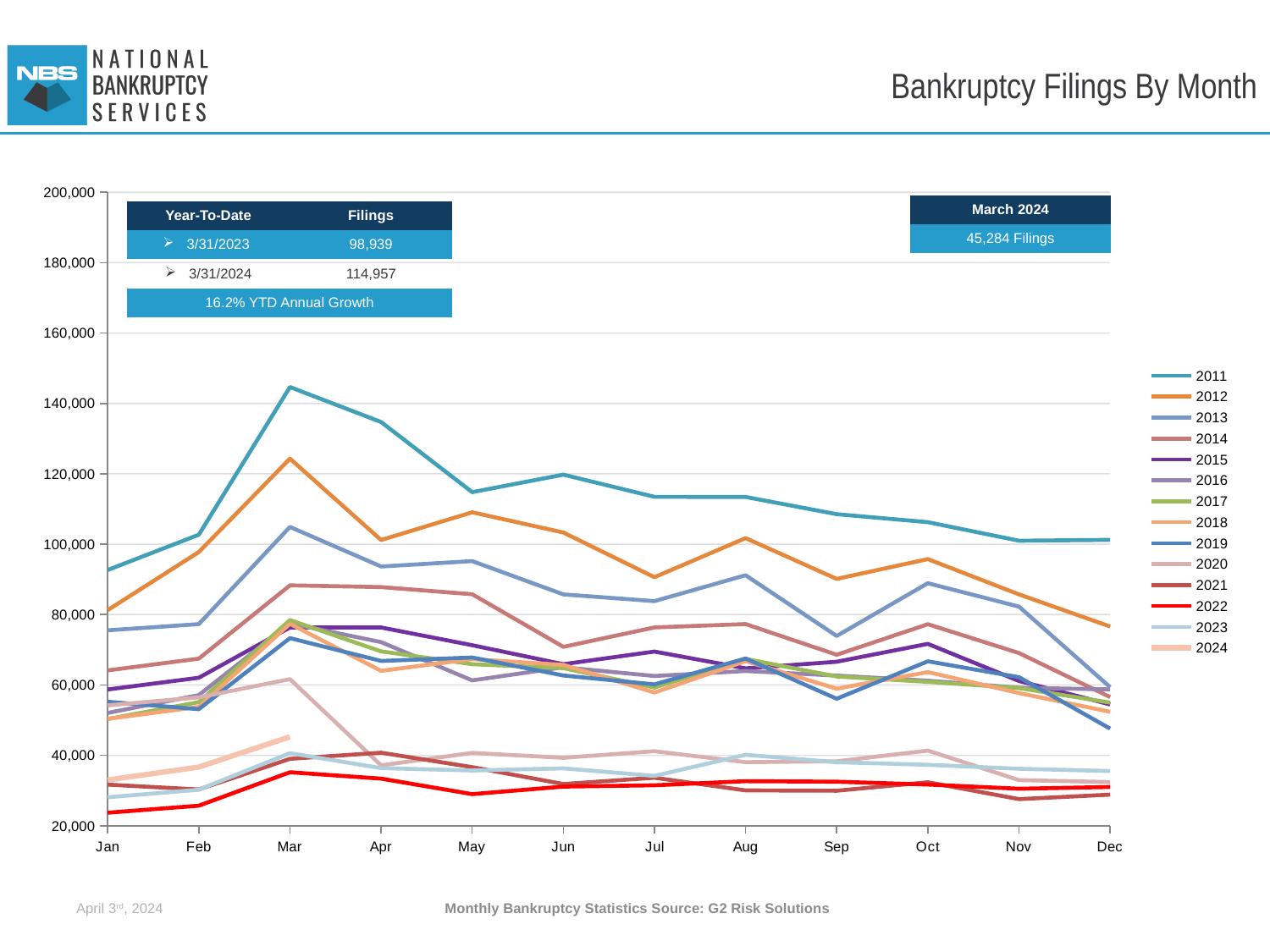
Is the value for 2011 in March greater or less than 140,000? greater What is the year-to-date filings figure for 3/31/2023 shown on the chart? 98,939 What YTD annual growth percentage is shown on the chart? 16.2% What kind of chart is shown on the slide? line chart Which is larger in January, the value for 2011 or the value for 2012? 2011 What is the year-to-date filings figure for 3/31/2024 shown on the chart? 114,957 How many series does the legend list? 14 How many months are shown along the x axis? 12 Is the value for 2022 in January greater or less than 40,000? less Which year has the highest value in March? 2011 How many filings were there in March 2024 according to the callout on the chart? 45,284 Does the 2011 line rise or fall from March to December? fall